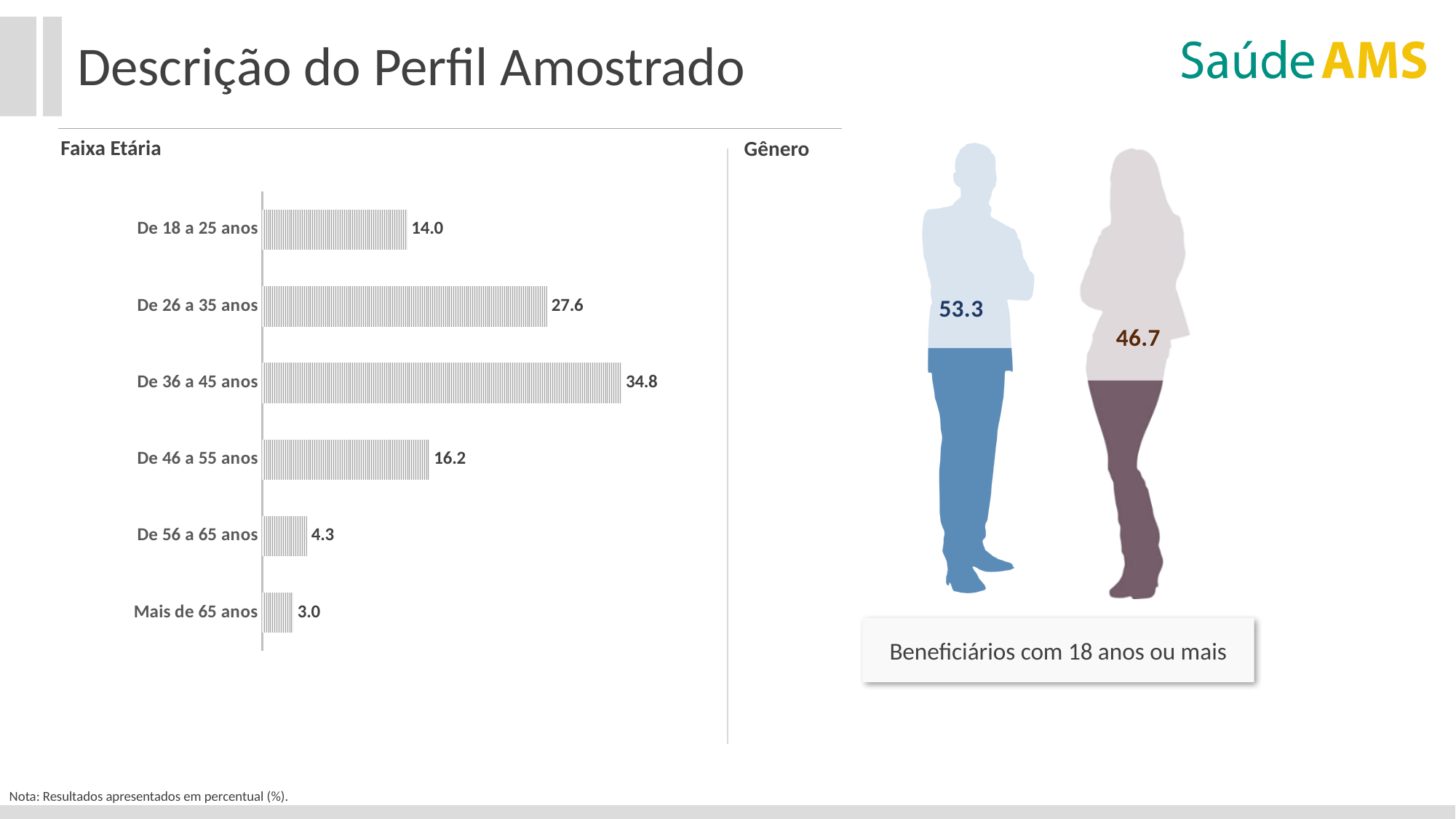
In the Faixa Etária chart, which age group has the lowest value? Mais de 65 anos In the Faixa Etária chart, which is larger: the value for De 18 a 25 anos or De 46 a 55 anos? De 46 a 55 anos According to the note at the bottom of the slide, in what unit are the results presented? Percentual (%) In the Faixa Etária chart, what is the value for De 36 a 45 anos? 34.8 In the Faixa Etária chart, what is the value for De 18 a 25 anos? 14.0 In the Faixa Etária chart, what is the difference between the values for De 26 a 35 anos and De 46 a 55 anos? 11.4 What kind of chart is the Faixa Etária chart? Bar chart In the Faixa Etária chart, which age group has the highest value? De 36 a 45 anos How many age groups are shown in the Faixa Etária chart? 6 In the Faixa Etária chart, what is the value for Mais de 65 anos? 3.0 In the Faixa Etária chart, what is the difference between the values for De 56 a 65 anos and Mais de 65 anos? 1.3 In the Gênero section, what is the value shown for the male figure? 53.3